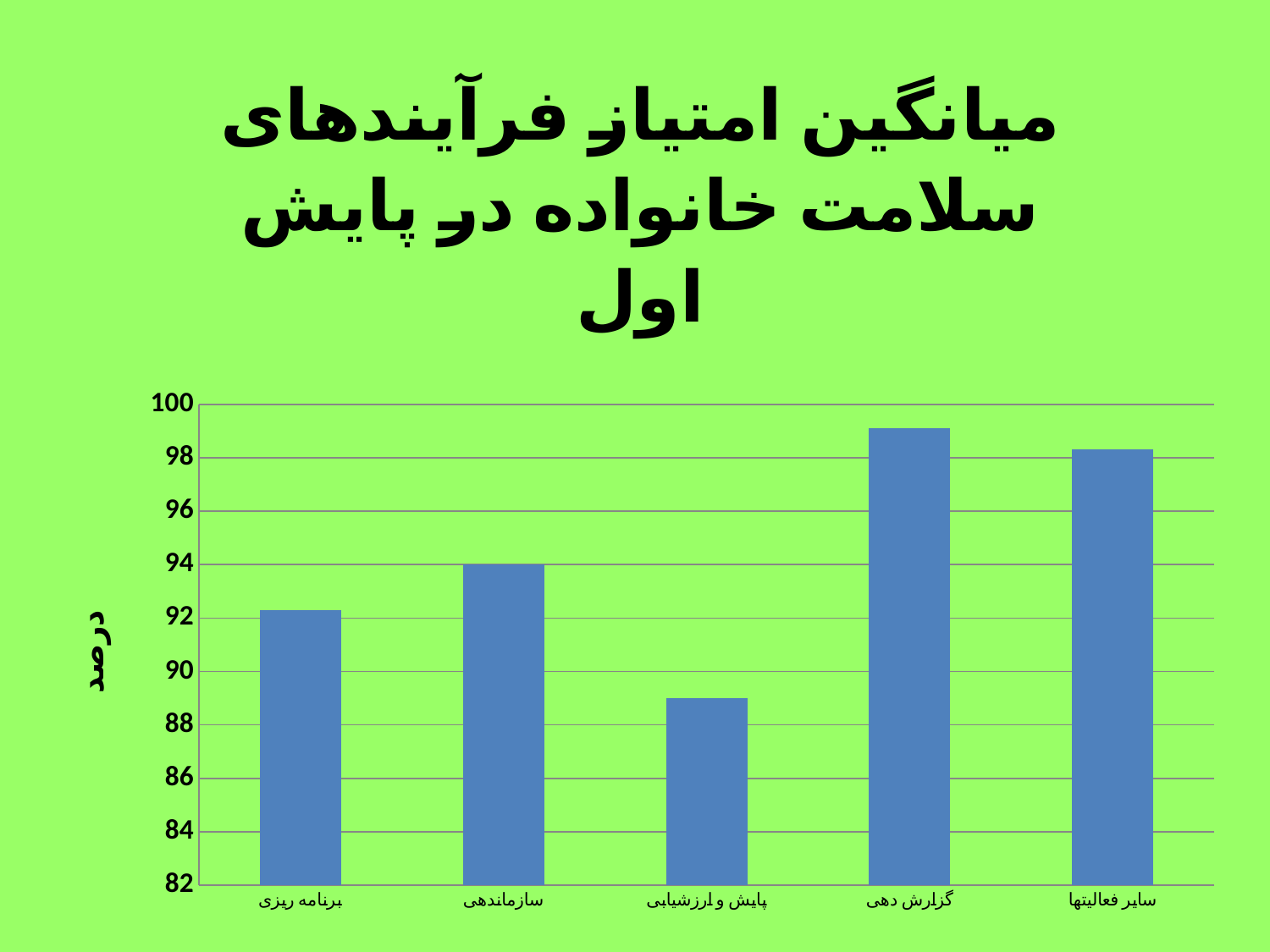
How many categories are shown on the x axis of the chart? 5 Is the value for پایش و ارزشیابی greater or less than 90? less Which is larger, the value for برنامه ریزی or the value for سازماندهی? سازماندهی Which category has the lowest value? پایش و ارزشیابی What is the label on the vertical axis of the chart? درصد Which is larger, the value for پایش و ارزشیابی or the value for سایر فعالیتها? سایر فعالیتها Is the value for سایر فعالیتها greater or less than 96? greater Is the value for برنامه ریزی greater or less than 94? less What is the value for سازماندهی? 94 Which category has the highest value? گزارش دهی What type of chart is shown on the slide? bar chart